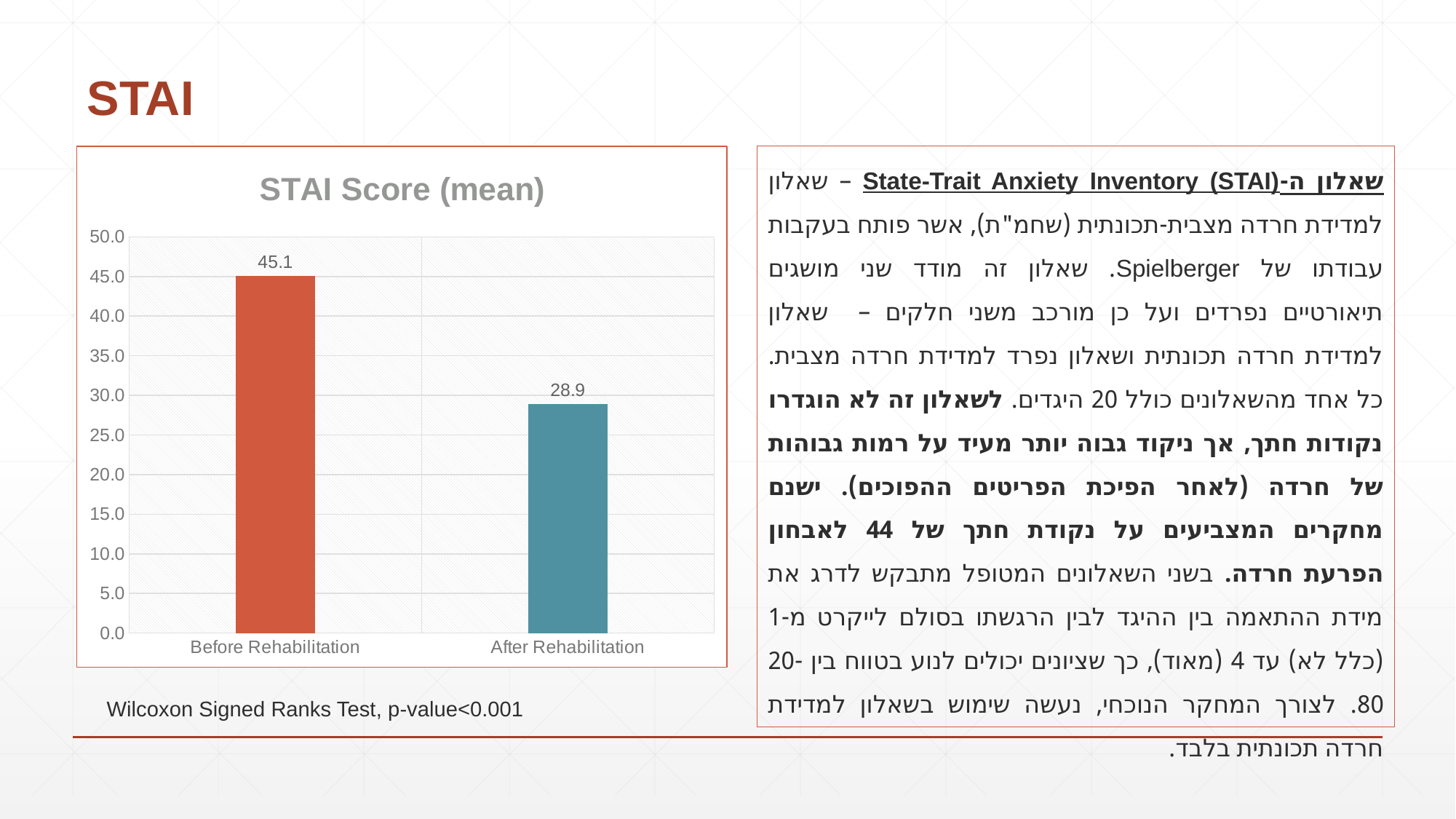
Is the mean STAI score for Before Rehabilitation greater or less than 40.0? greater How many categories are shown in the chart? 2 What is the mean STAI score for After Rehabilitation? 28.9 Do the values rise or fall from Before Rehabilitation to After Rehabilitation? Fall What is the title of the chart? STAI Score (mean) Is the mean STAI score for After Rehabilitation greater or less than 30.0? less What is the difference between the Before Rehabilitation and After Rehabilitation mean STAI scores? 16.2 Which category has the highest mean STAI score? Before Rehabilitation What kind of chart is shown on the slide? Bar chart Which category has the lowest mean STAI score? After Rehabilitation What is the mean STAI score for Before Rehabilitation? 45.1 Which is larger, the mean STAI score Before Rehabilitation or After Rehabilitation? Before Rehabilitation